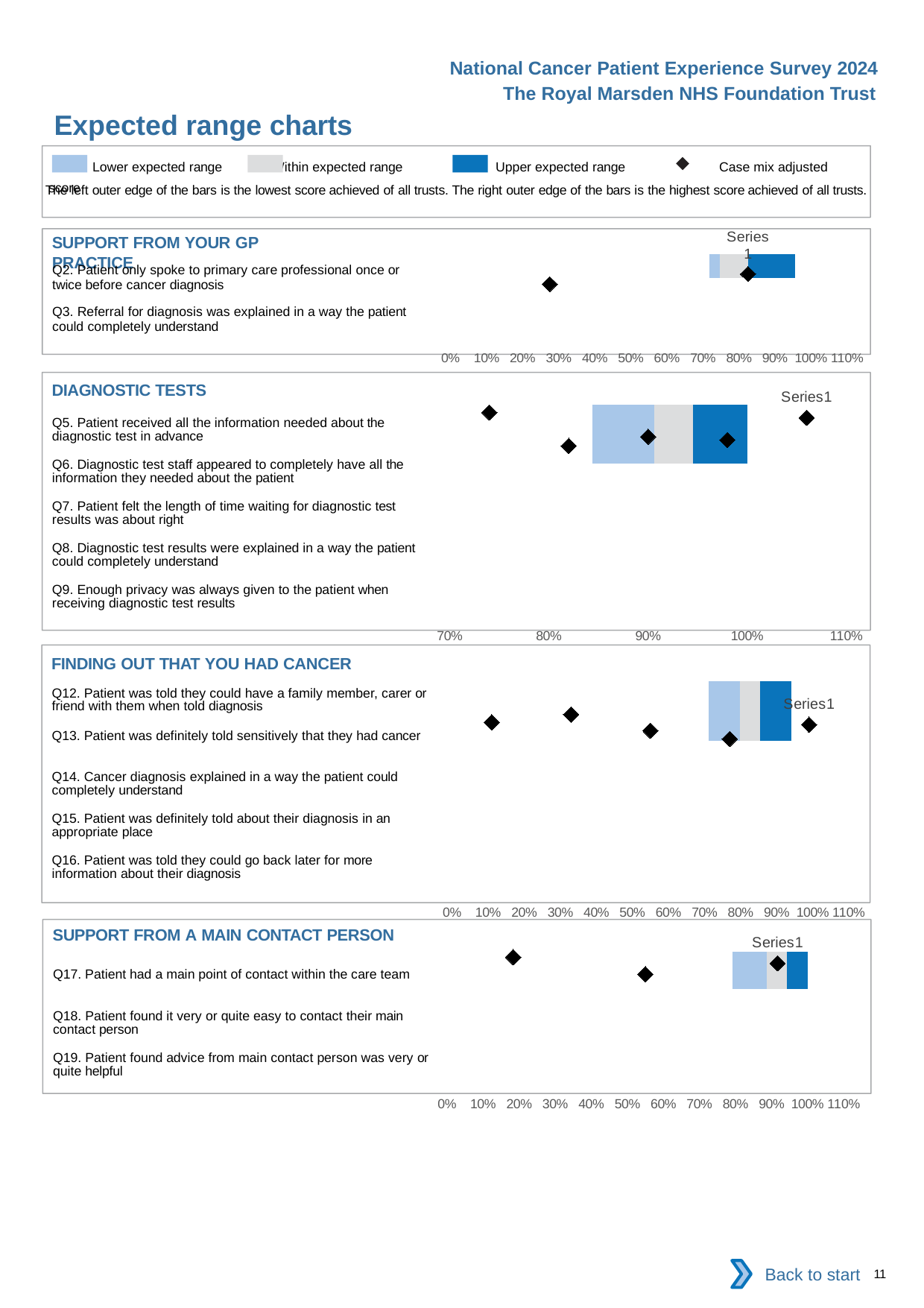
In the DIAGNOSTIC TESTS chart, how many diamond markers are plotted? 5 What kind of chart is the DIAGNOSTIC TESTS chart? bar chart In the SUPPORT FROM A MAIN CONTACT PERSON chart, is the rightmost diamond marker greater or less than 80%? greater In the SUPPORT FROM A MAIN CONTACT PERSON chart, how many questions are listed? 3 What is the lowest value shown on the x axis of the DIAGNOSTIC TESTS chart? 70% According to the legend at the top of the slide, what does the dark blue colour represent? Upper expected range In the SUPPORT FROM A MAIN CONTACT PERSON chart, how many diamond markers are plotted? 3 In the SUPPORT FROM YOUR GP PRACTICE chart, is the leftmost diamond marker greater or less than 50%? less